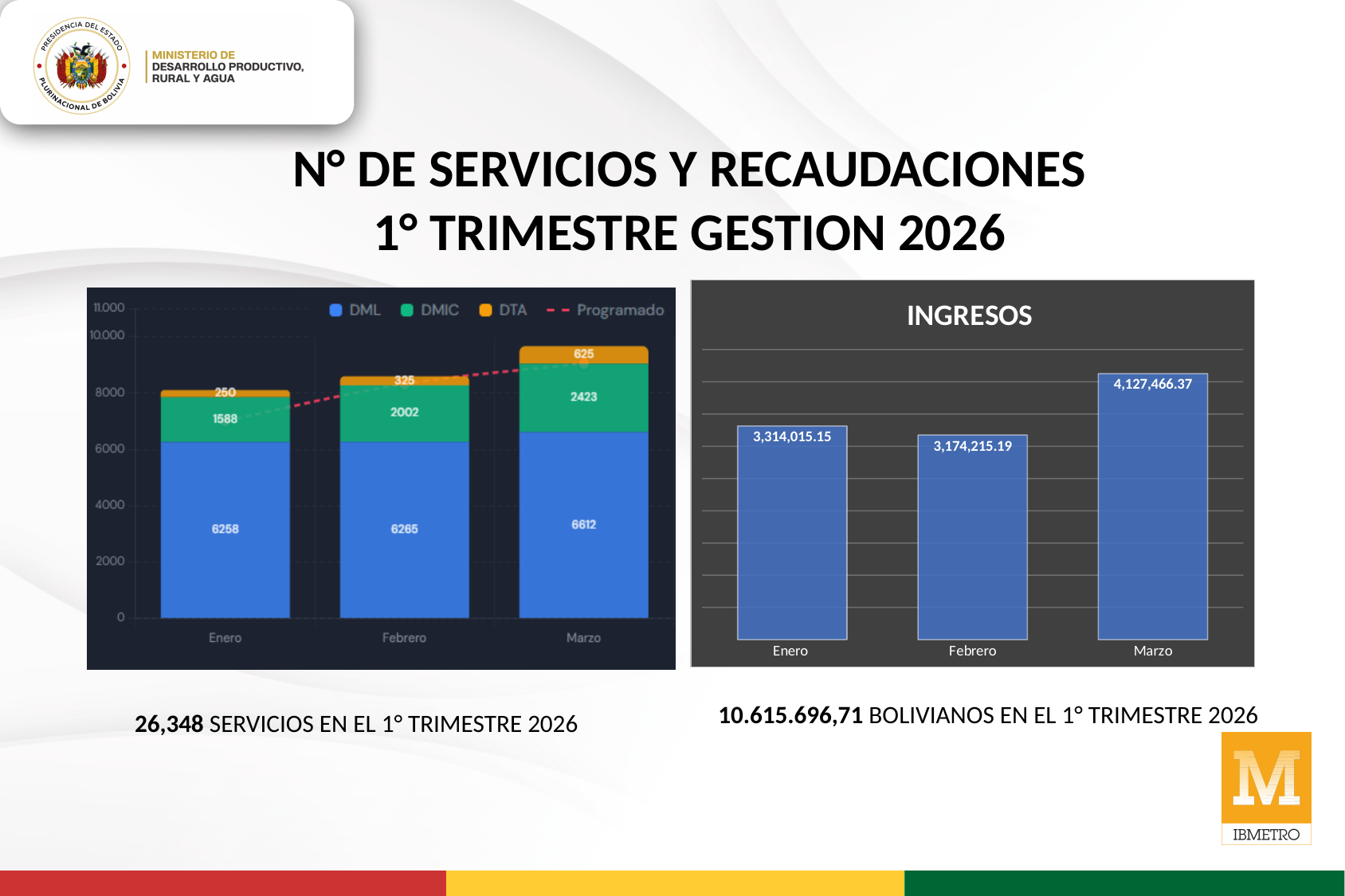
In the INGRESOS chart, which is larger, the value for Enero or the value for Febrero? Enero In the INGRESOS chart, what is the value for Marzo? 4,127,466.37 In the left stacked bar chart, which month has the highest DTA value? Marzo In the left stacked bar chart, what is the DMIC value for Febrero? 2002 In the INGRESOS chart, how many months are plotted? 3 In the left stacked bar chart, what is the total of the stacked bar for Marzo? 9660 In the INGRESOS chart, which month has the lowest value? Febrero In the left stacked bar chart, what is the DML value for Marzo? 6612 In the left stacked bar chart, what is the DTA value for Enero? 250 In the left stacked bar chart, what is the difference between the DMIC values for Marzo and Enero? 835 What kind of chart is the INGRESOS chart? Bar chart In the left stacked bar chart, how many entries does the legend list? 4